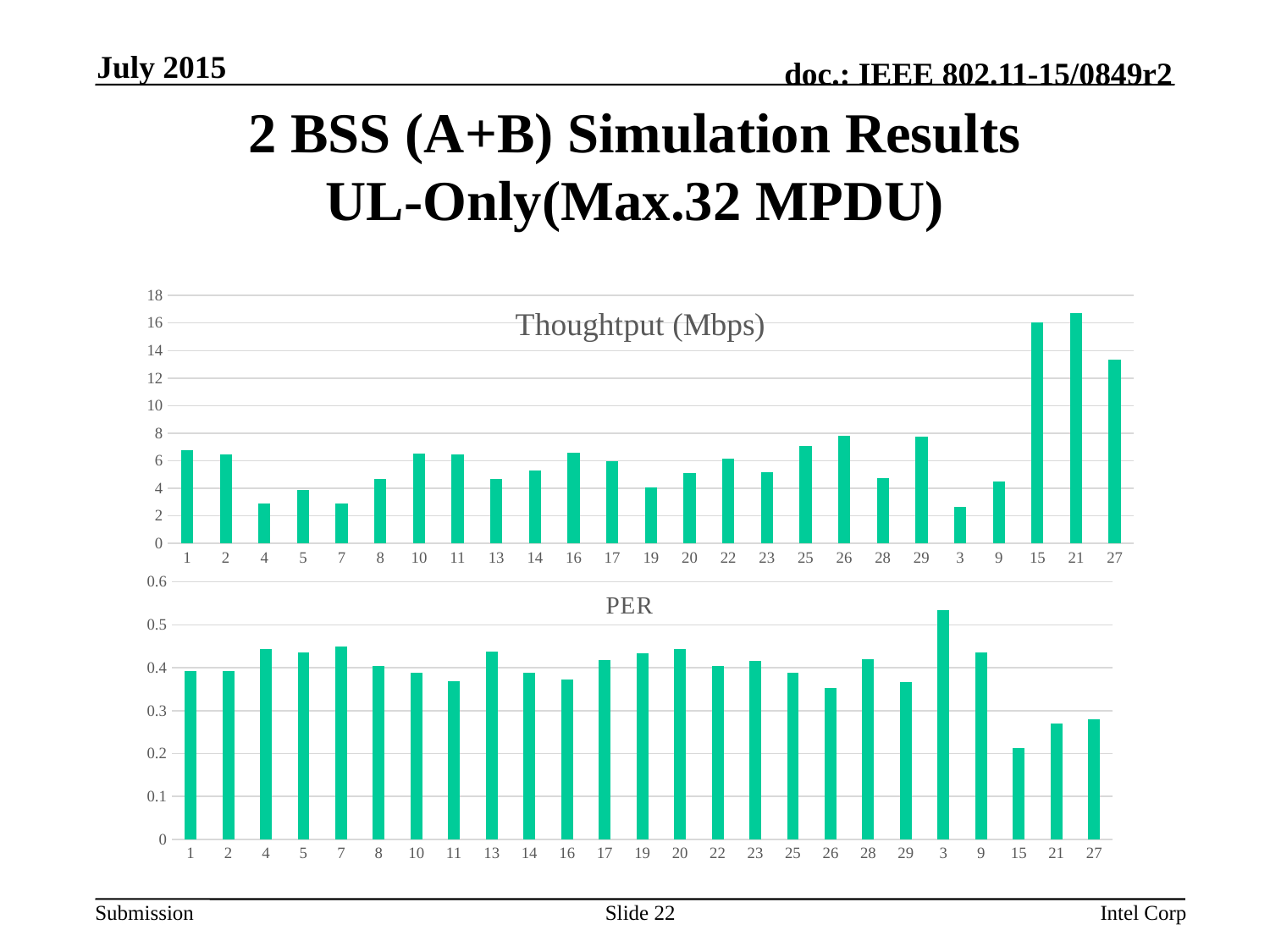
In the Thoughtput (Mbps) chart, which category has the lowest value? 3 In the PER chart, which category has the lowest value? 15 What is the title of the lower chart on the slide? PER In the PER chart, is the value for category 3 greater or less than 0.5? greater In the PER chart, which category has the highest value? 3 In the Thoughtput (Mbps) chart, which is larger, the value for category 26 or category 4? 26 How many categories are shown on the x axis of the PER chart? 25 In the Thoughtput (Mbps) chart, is the value for category 4 greater or less than 4? less What kind of chart is the Thoughtput (Mbps) chart? bar chart In the Thoughtput (Mbps) chart, is the value for category 15 greater or less than 14? greater In the Thoughtput (Mbps) chart, which category has the highest value? 21